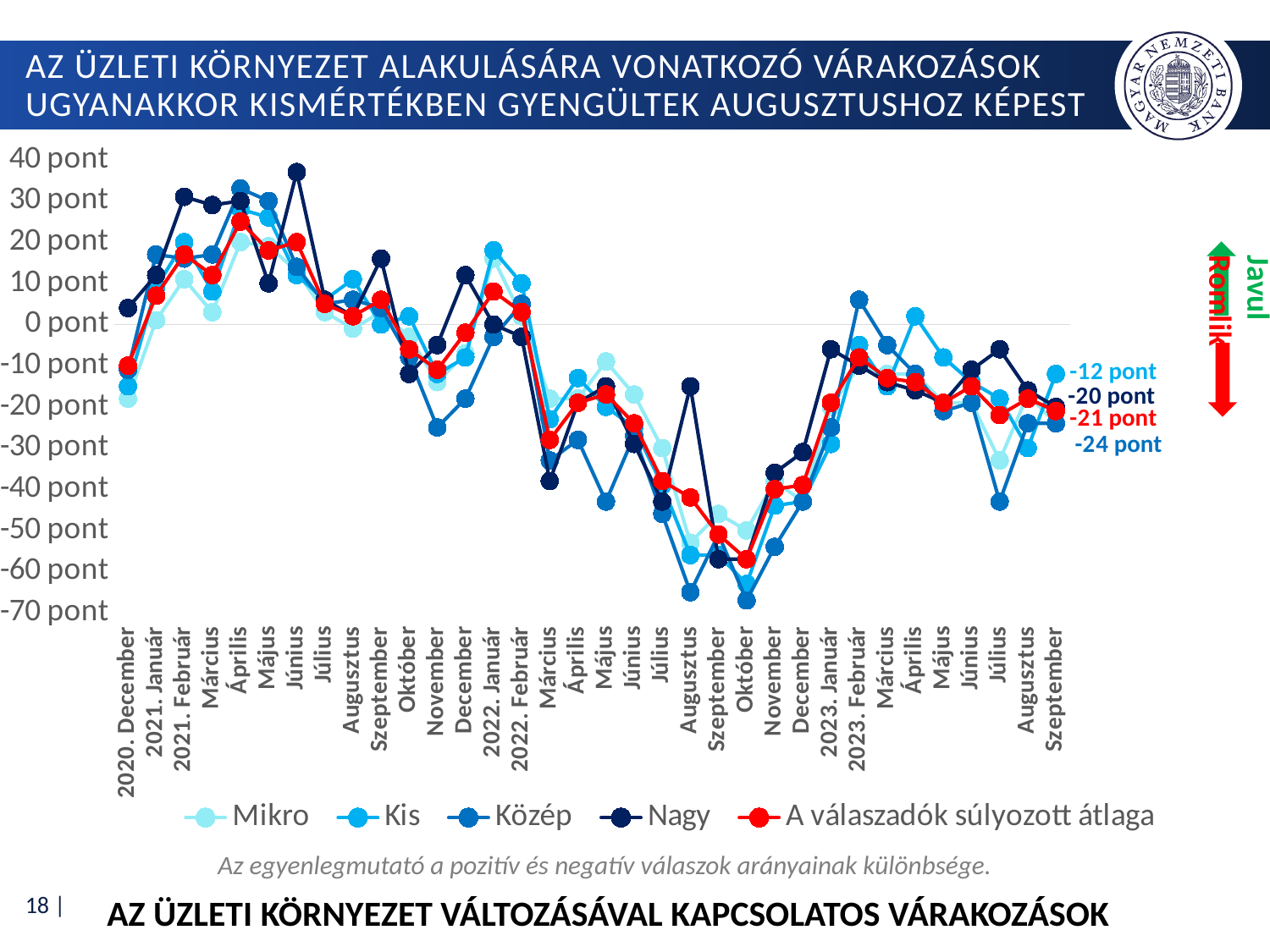
Is the value for the Nagy series in 2021 Június greater or less than 30 pont? greater What is the value for the Közép series in 2023 September? -24 pont Which is higher in 2023 September, the Kis series or the Közép series? Kis What is the value for the Nagy series in 2023 September? -20 pont Among the series with labelled values in 2023 September, which has the highest value? Kis Is the value of 'A válaszadók súlyozott átlaga' in 2022 Október greater or less than -50 pont? less Which series is drawn in red in the legend? A válaszadók súlyozott átlaga How many series does the legend list? 5 What is the value for the Kis series in 2023 September? -12 pont What kind of chart is shown on the slide? line chart What is the value of 'A válaszadók súlyozott átlaga' in 2023 September? -21 pont What is the difference between the Kis and Közép values in 2023 September? 12 pont